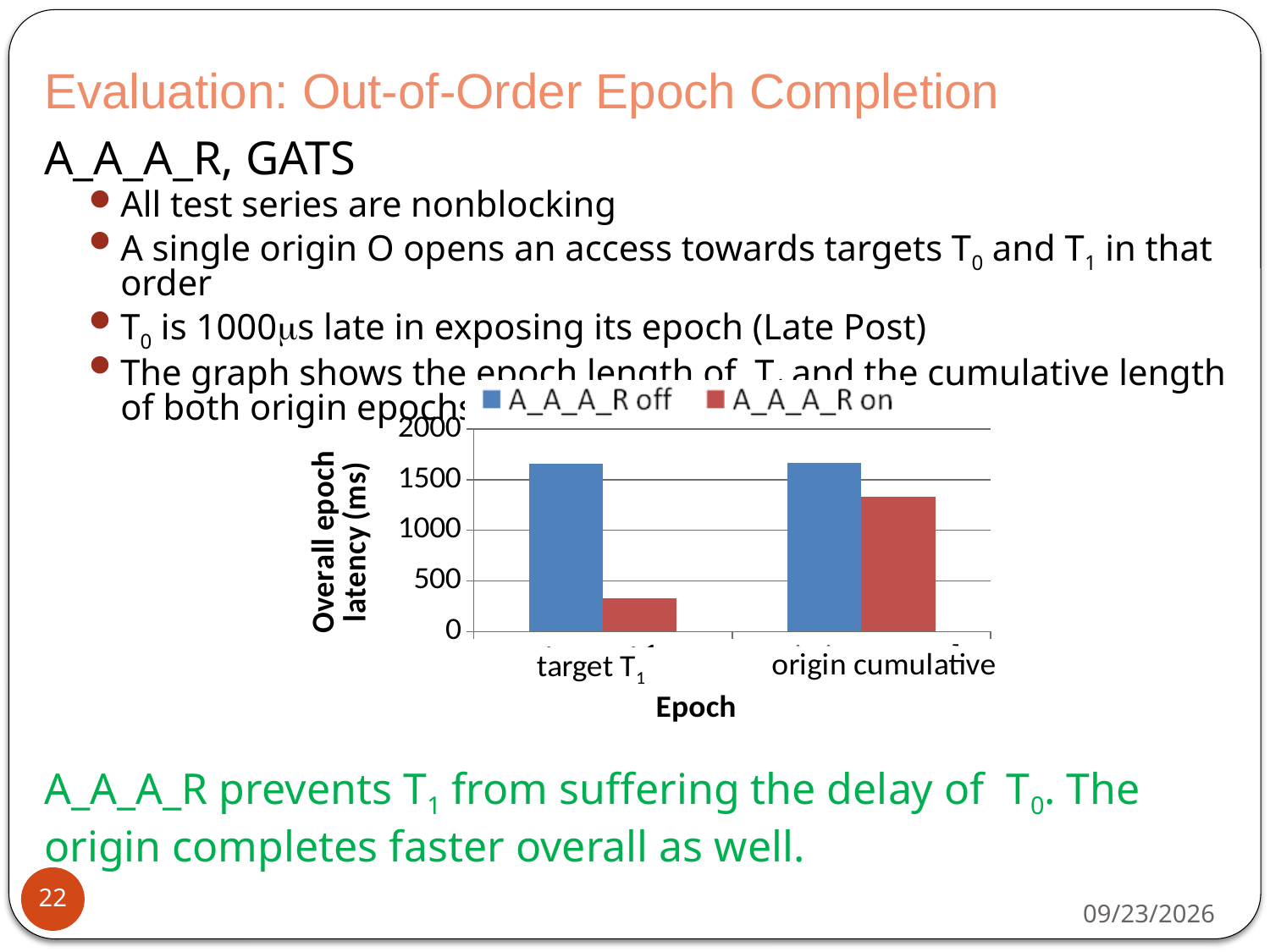
For target T1, which series has the larger value, A_A_A_R off or A_A_A_R on? A_A_A_R off Is the A_A_A_R off value for origin cumulative greater or less than 2000? less What kind of chart is shown on the slide? bar chart Is the A_A_A_R off value for target T1 greater or less than 1500? greater How many categories are shown on the x axis of the chart? 2 What is the label of the chart's y axis? Overall epoch latency (ms) What are the two series named in the chart legend? A_A_A_R off and A_A_A_R on Is the A_A_A_R on value for origin cumulative greater or less than 1000? greater How many series does the chart legend list? 2 Which category has the lowest value in the A_A_A_R on series? target T1 Which category has the highest value in the A_A_A_R on series? origin cumulative